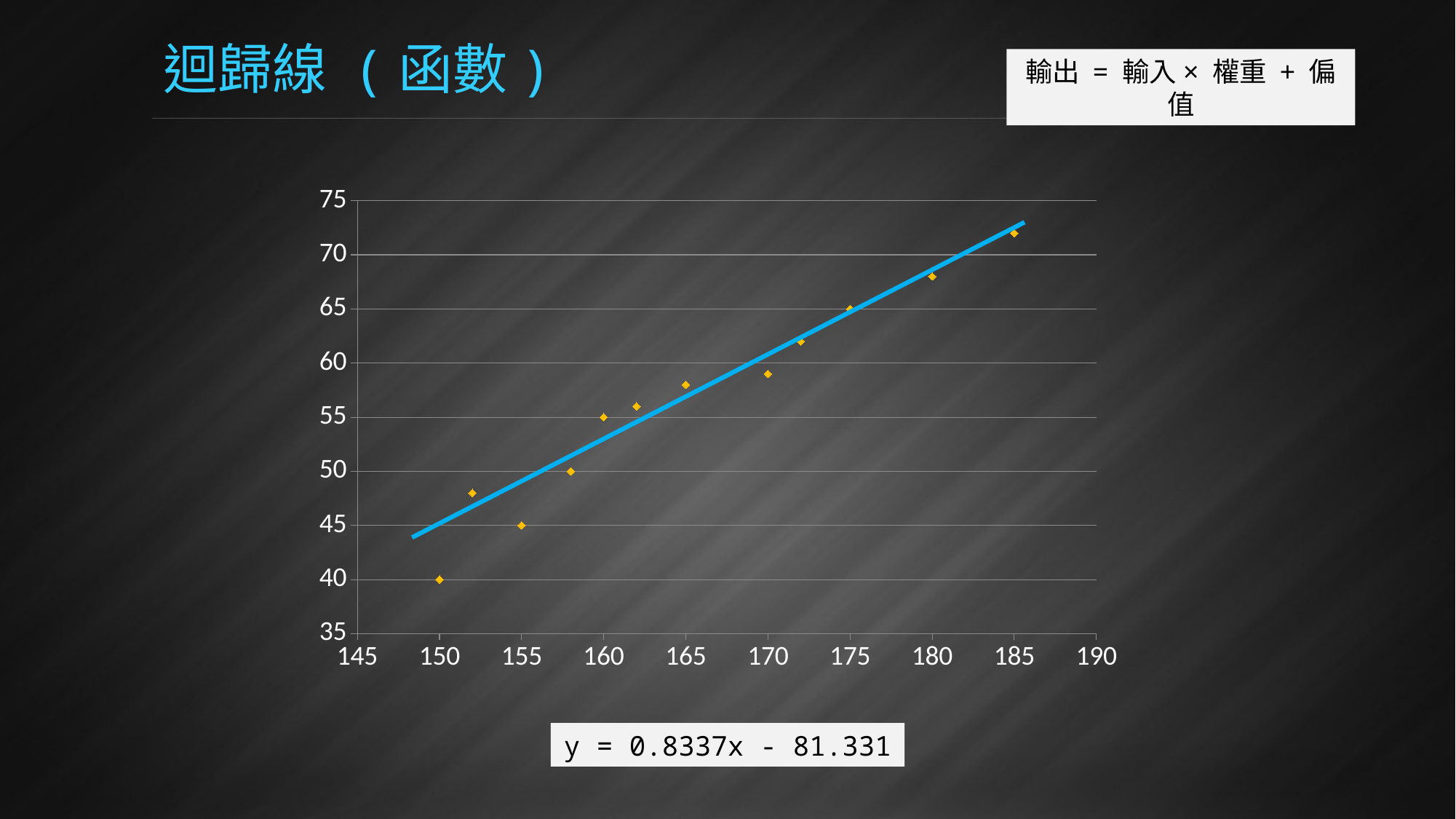
Which point has the larger y value, the one at x = 152 or the one at x = 155? x = 152 Is the y value of the point at x = 170 greater or less than 60? less What kind of chart is shown on the slide? scatter chart What is the y value of the data point at x = 175? 65 Is the y value of the point at x = 185 greater or less than 70? greater How many data points are plotted on the chart? 12 What is the y value of the data point at x = 150? 40 What is the y value of the data point at x = 155? 45 At which x value is the lowest plotted point? 150 At which x value is the highest plotted point? 185 Do the plotted values rise or fall as x increases along the x axis? rise What is the trendline equation shown below the chart? y = 0.8337x - 81.331